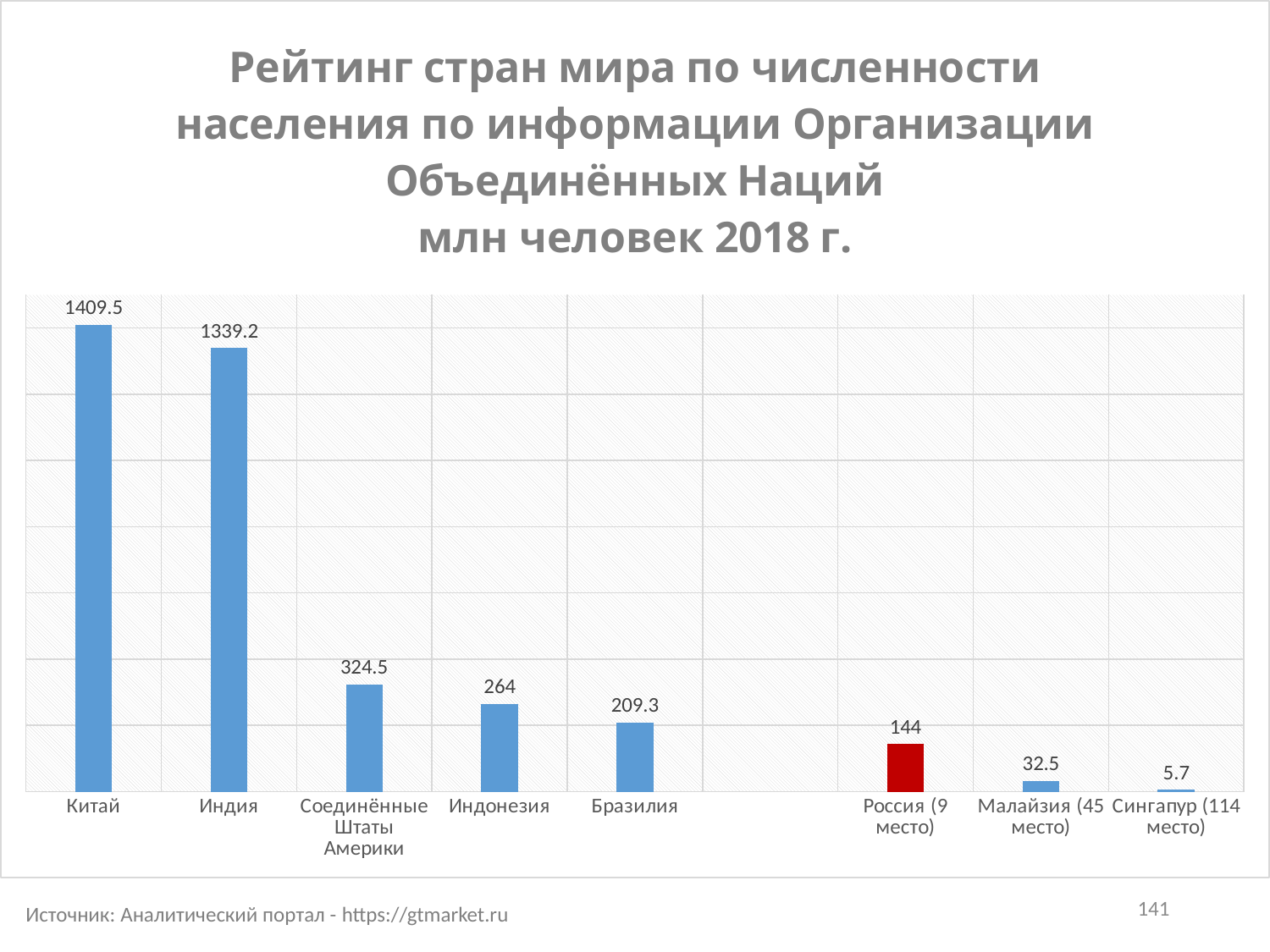
What value is shown for Сингапур (114 место)? 5.7 What value is shown for Индонезия? 264 What kind of chart is shown on the slide? Bar chart What is the difference between the values for Россия (9 место) and Малайзия (45 место)? 111.5 Which is larger, the value for Соединённые Штаты Америки or the value for Бразилия? Соединённые Штаты Америки What is the population value shown for Китай? 1409.5 What value is shown for Россия (9 место)? 144 Which country has the highest value on the chart? Китай What is the difference between the values for Китай and Индия? 70.3 How many countries are shown on the chart? 8 Which bar is coloured red instead of blue? Россия (9 место) Which country has the lowest value on the chart? Сингапур (114 место)